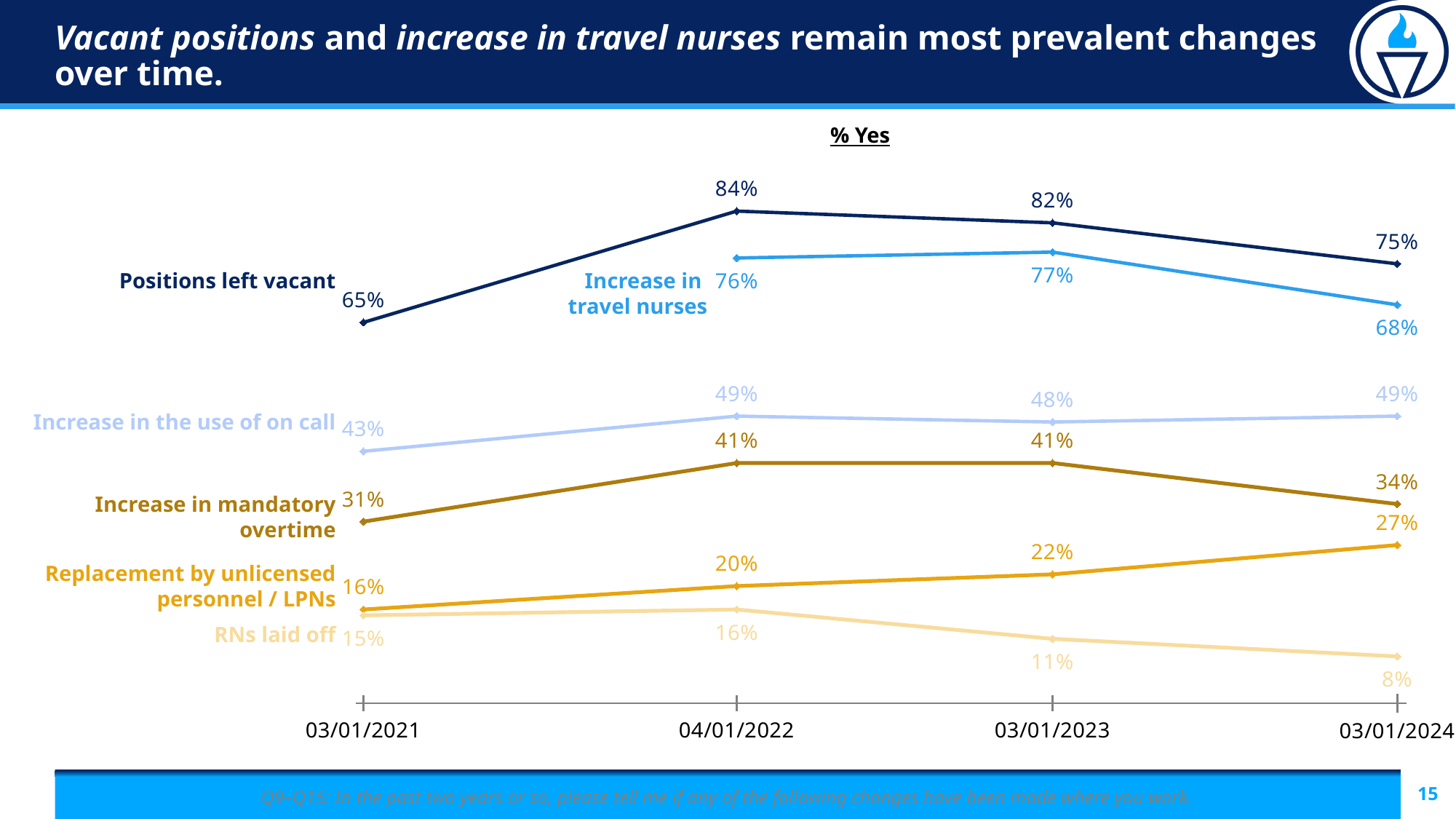
Does the value for Replacement by unlicensed personnel / LPNs rise or fall from 03/01/2021 to 03/01/2024? Rise How many time points are shown on the x axis? 4 What kind of chart is shown on the slide? Line chart What is the value for Increase in travel nurses on 03/01/2024? 68% What is the value for Positions left vacant on 04/01/2022? 84% Which is larger on 04/01/2022: Increase in the use of on call or Increase in mandatory overtime? Increase in the use of on call Which series has the highest value on 03/01/2024? Positions left vacant What is the value for Increase in mandatory overtime on 03/01/2021? 31% What is the value for RNs laid off on 03/01/2023? 11% Which series has the lowest value on 03/01/2024? RNs laid off How many series are plotted on the chart? 6